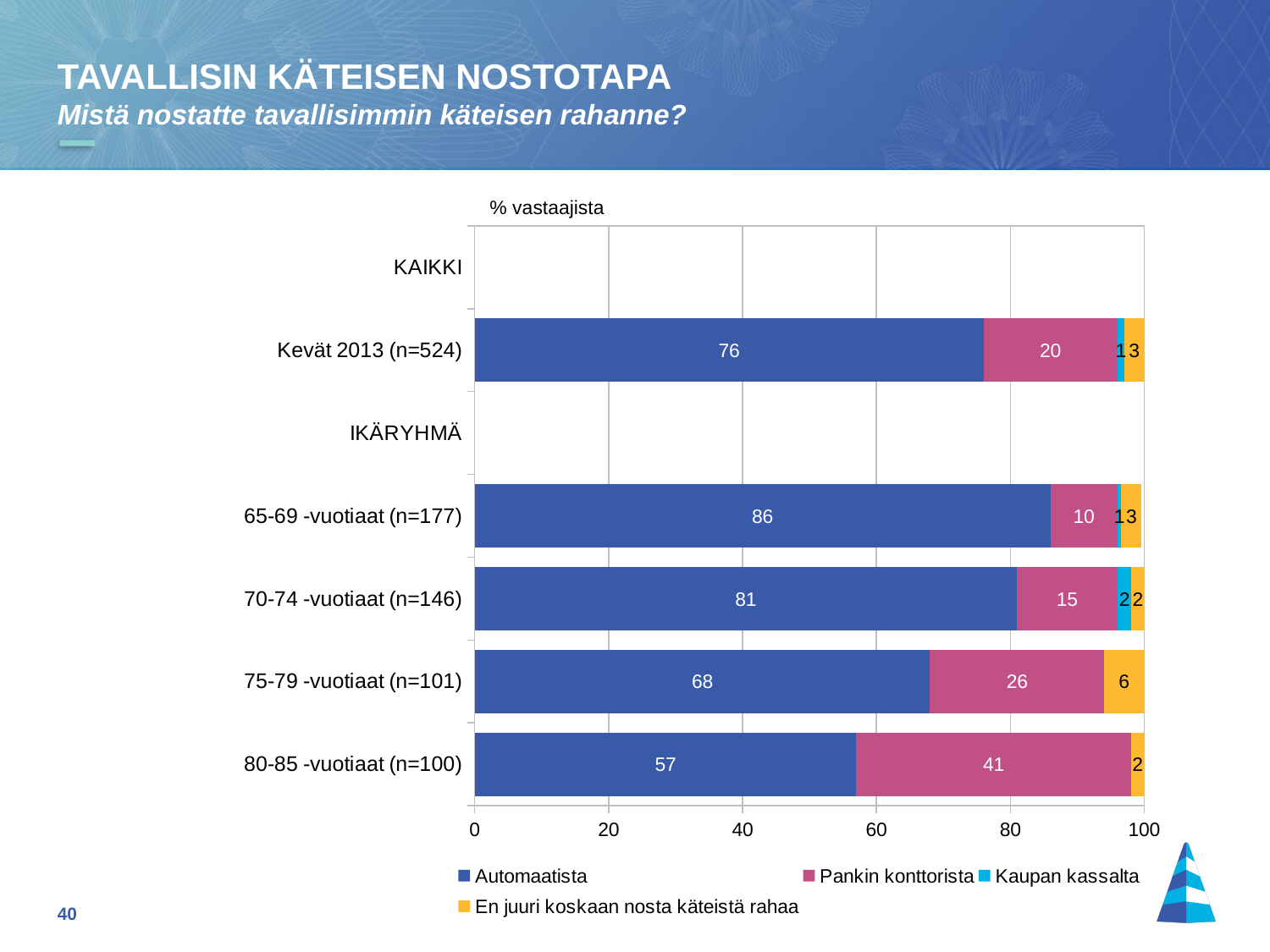
What unit is shown above the chart for the values? % vastaajista Which is larger: the Pankin konttorista value for 75-79 -vuotiaat (n=101) or for 70-74 -vuotiaat (n=146)? 75-79 -vuotiaat (n=101) What is the difference between the Automaatista values for 65-69 -vuotiaat (n=177) and 80-85 -vuotiaat (n=100)? 29 What is the Pankin konttorista value for 80-85 -vuotiaat (n=100)? 41 Does the Automaatista value rise or fall as the age groups get older from 65-69 to 80-85? fall Which age group has the highest Automaatista value? 65-69 -vuotiaat (n=177) What type of chart is shown on the slide? stacked bar chart Which age group has the lowest Automaatista value? 80-85 -vuotiaat (n=100) How many series does the legend list? 4 What is the En juuri koskaan nosta käteistä rahaa value for 75-79 -vuotiaat (n=101)? 6 What is the Automaatista value for Kevät 2013 (n=524)? 76 Is the Automaatista value for 70-74 -vuotiaat (n=146) greater or less than 80? greater